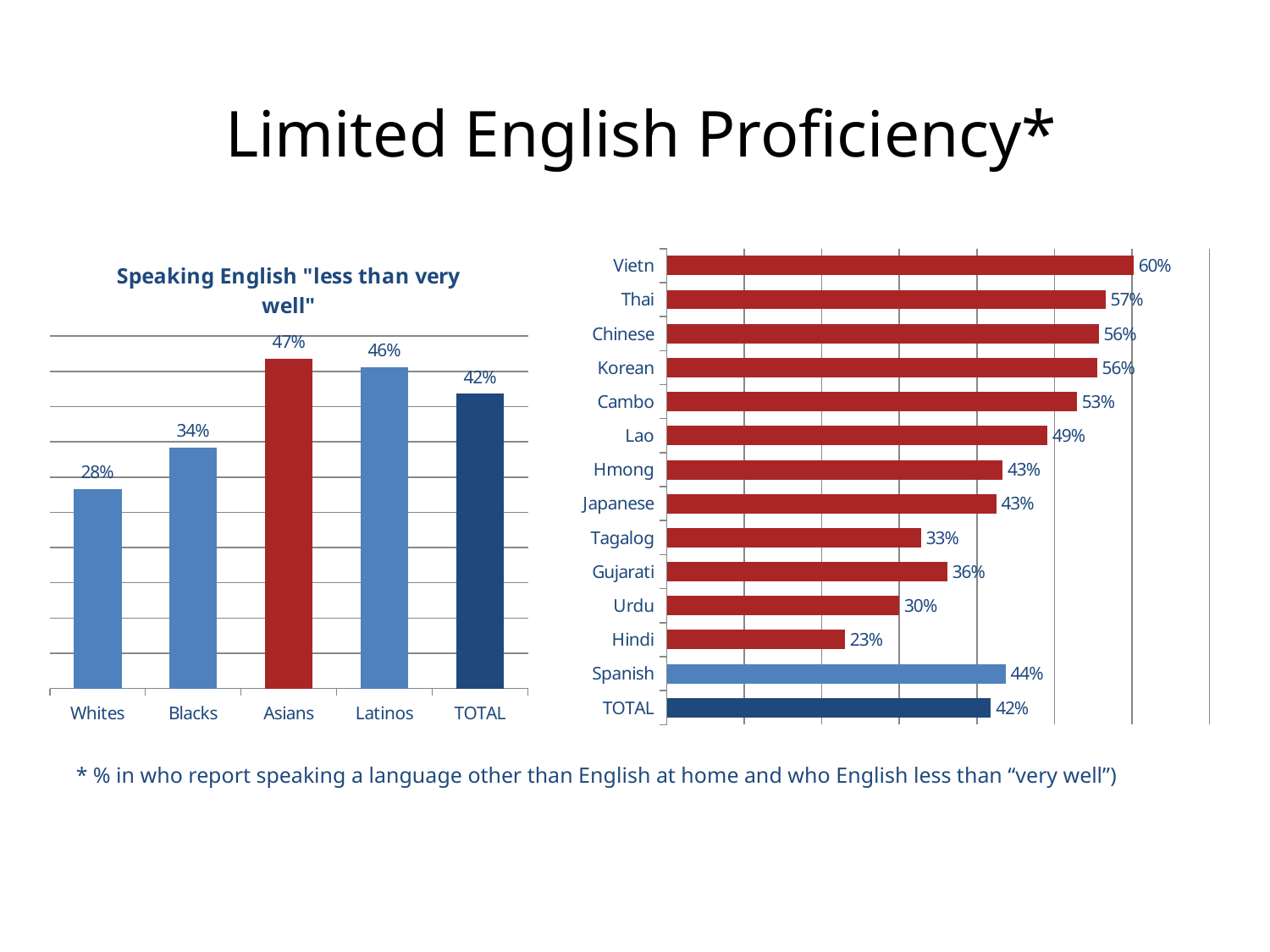
In the right chart, what is the difference between the values for Vietn and Spanish? 16% In the right chart, how many categories are shown? 14 In the right chart, which category has the highest value? Vietn In the left chart titled 'Speaking English "less than very well"', which category has the lowest value? Whites In the left chart titled 'Speaking English "less than very well"', what is the value for Asians? 47% In the right chart, what is the value for TOTAL? 42% In the left chart titled 'Speaking English "less than very well"', what is the difference between the values for Latinos and Blacks? 12% In the right chart, which category has the lowest value? Hindi In the right chart, which is larger, the value for Gujarati or the value for Tagalog? Gujarati In the left chart titled 'Speaking English "less than very well"', how many categories are shown? 5 What kind of chart is the left chart titled 'Speaking English "less than very well"'? bar chart In the right chart, what is the value for Cambo? 53%